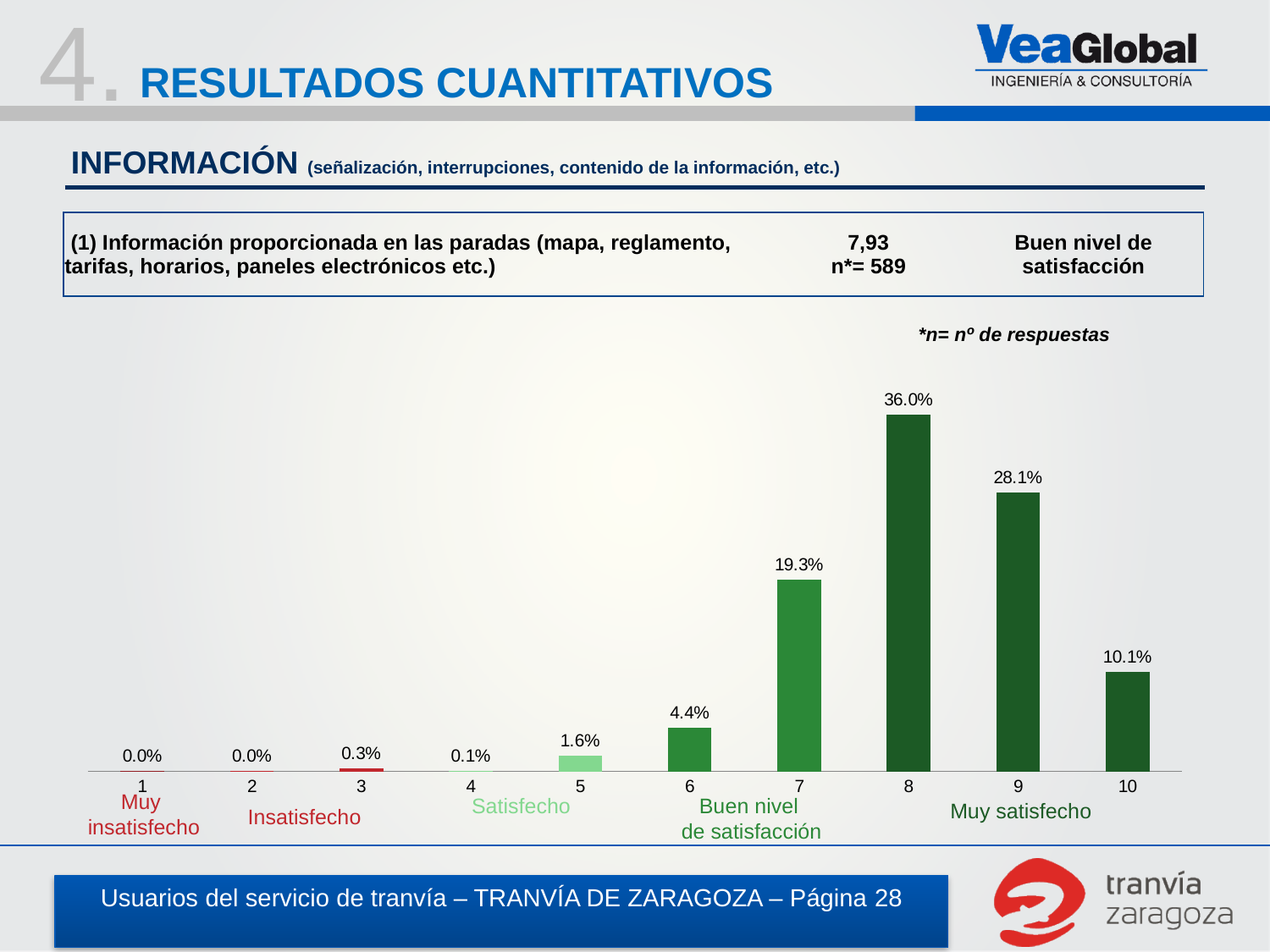
How many categories are shown on the x axis? 10 What is the value for category 10? 10.1% What label is shown under category 1 on the x axis? Muy insatisfecho What is the value for category 5? 1.6% What is the value for category 8? 36.0% What is the value for category 9? 28.1% Which is larger, the value for category 7 or the value for category 10? 7 What kind of chart is this? bar chart What is the value for category 3? 0.3% Which category has the highest value? 8 What is the difference between the values for categories 8 and 9? 7.9% What is the difference between the values for categories 6 and 7? 14.9%